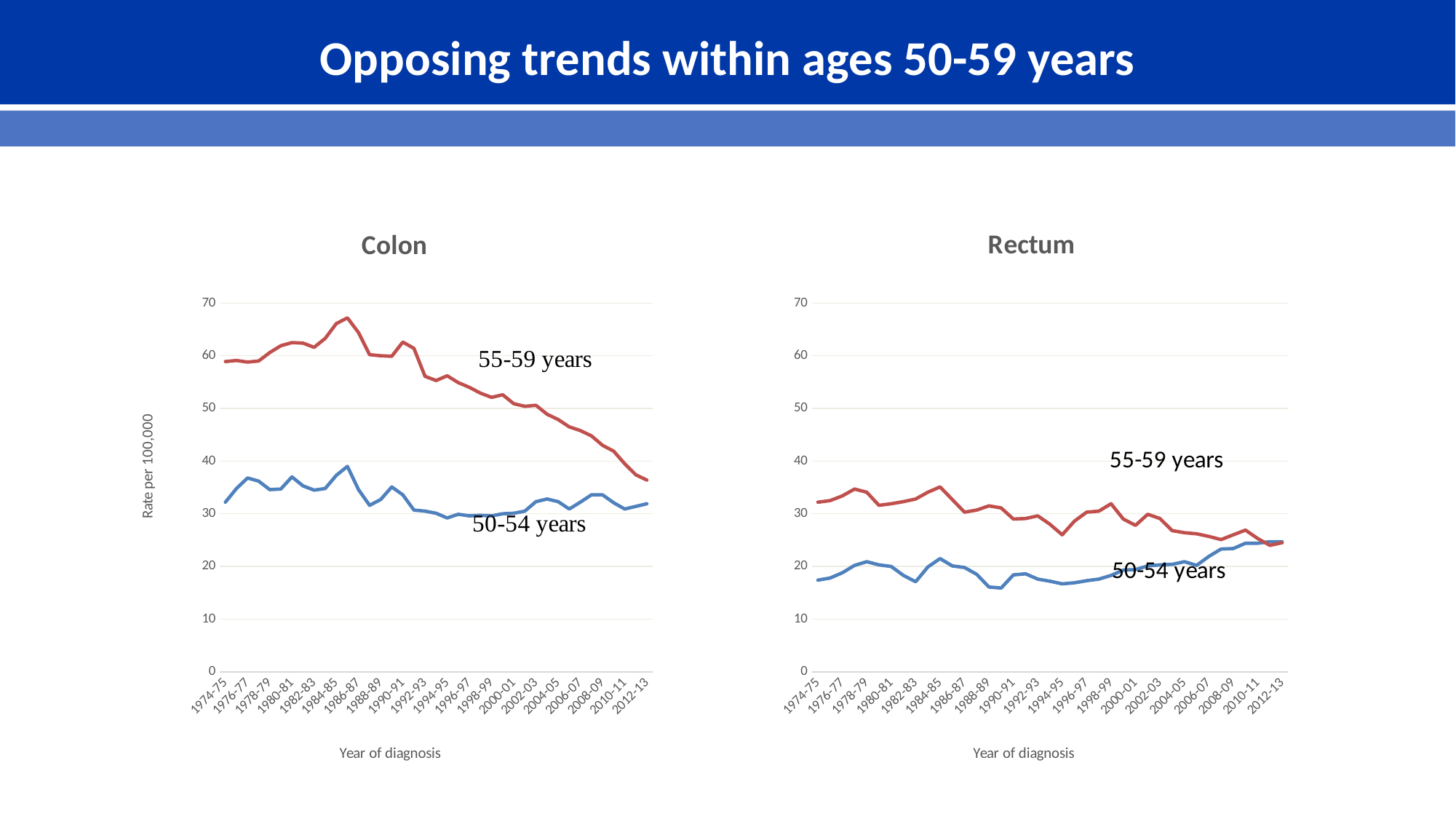
What kind of chart is the Colon chart? line chart On the Rectum chart, is the 55-59 years value for 1974-75 greater or less than 30? greater How many series are plotted on the Rectum chart? 2 On the Colon chart, does the 55-59 years line rise or fall overall from 1974-75 to 2012-13? fall On the Colon chart, is the 55-59 years value for 1986-87 greater or less than 60? greater What is the y-axis label on the Colon chart? Rate per 100,000 On the Colon chart, is the 55-59 years value for 2012-13 greater or less than 40? less On the Colon chart, which series has the higher value in 1974-75, 55-59 years or 50-54 years? 55-59 years On the Rectum chart, does the 50-54 years line rise or fall overall from 1974-75 to 2012-13? rise On the Rectum chart, does the 55-59 years line rise or fall overall from 1974-75 to 2012-13? fall